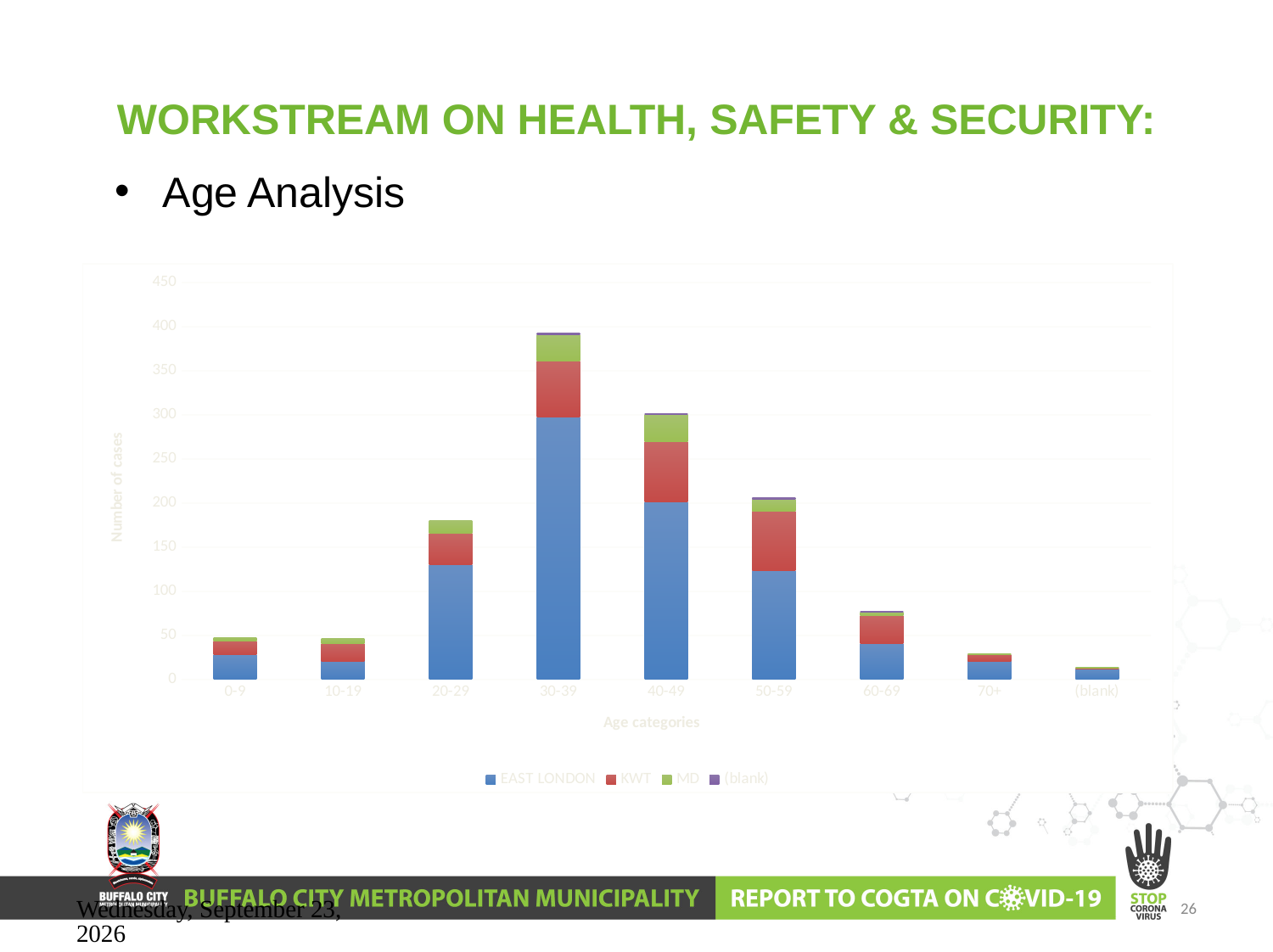
Which age category has the shortest stacked bar? (blank) What kind of chart is shown on the slide? stacked bar chart How many age categories are shown on the x axis of the chart? 9 Which age category has the tallest stacked bar? 30-39 Is the total value for the 70+ bar greater or less than 50? less Which stacked bar is taller, 20-29 or 60-69? 20-29 What is the title of the chart's vertical axis? Number of cases Is the total value for the 20-29 bar greater or less than 150? greater How many series does the chart's legend list? 4 Which series is listed first in the chart's legend? EAST LONDON Which stacked bar is taller, 30-39 or 40-49? 30-39 Is the total value for the 30-39 bar greater or less than 350? greater